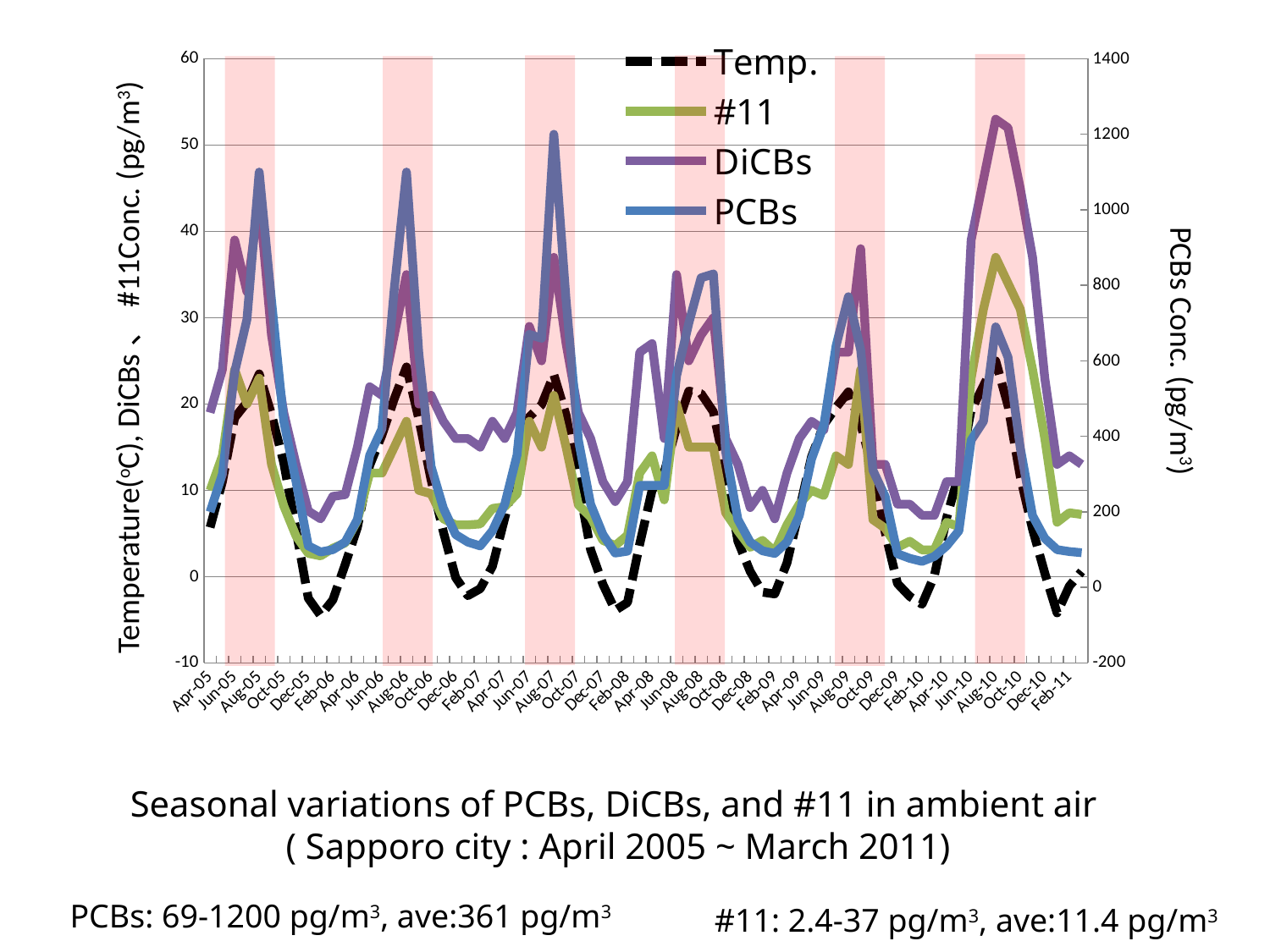
How many month labels are shown along the x axis? 36 In which month does the DiCBs series reach its highest peak? Aug-10 What is the label of the right-hand vertical axis? PCBs Conc. (pg/m3) Is the DiCBs value at Aug-10 greater or less than 50 on the left axis? greater Is the Temp. value at Feb-06 greater or less than 0? less What kind of chart is shown on the slide? line chart Is the PCBs value at Aug-07 greater or less than 1000 on the right axis? greater How many series does the legend list? 4 Does the #11 series rise or fall from Jun-10 to Aug-10? rise Which series in the legend is drawn with a dashed line? Temp. Which is larger, the DiCBs peak at Aug-10 or the DiCBs peak at Aug-05? Aug-10